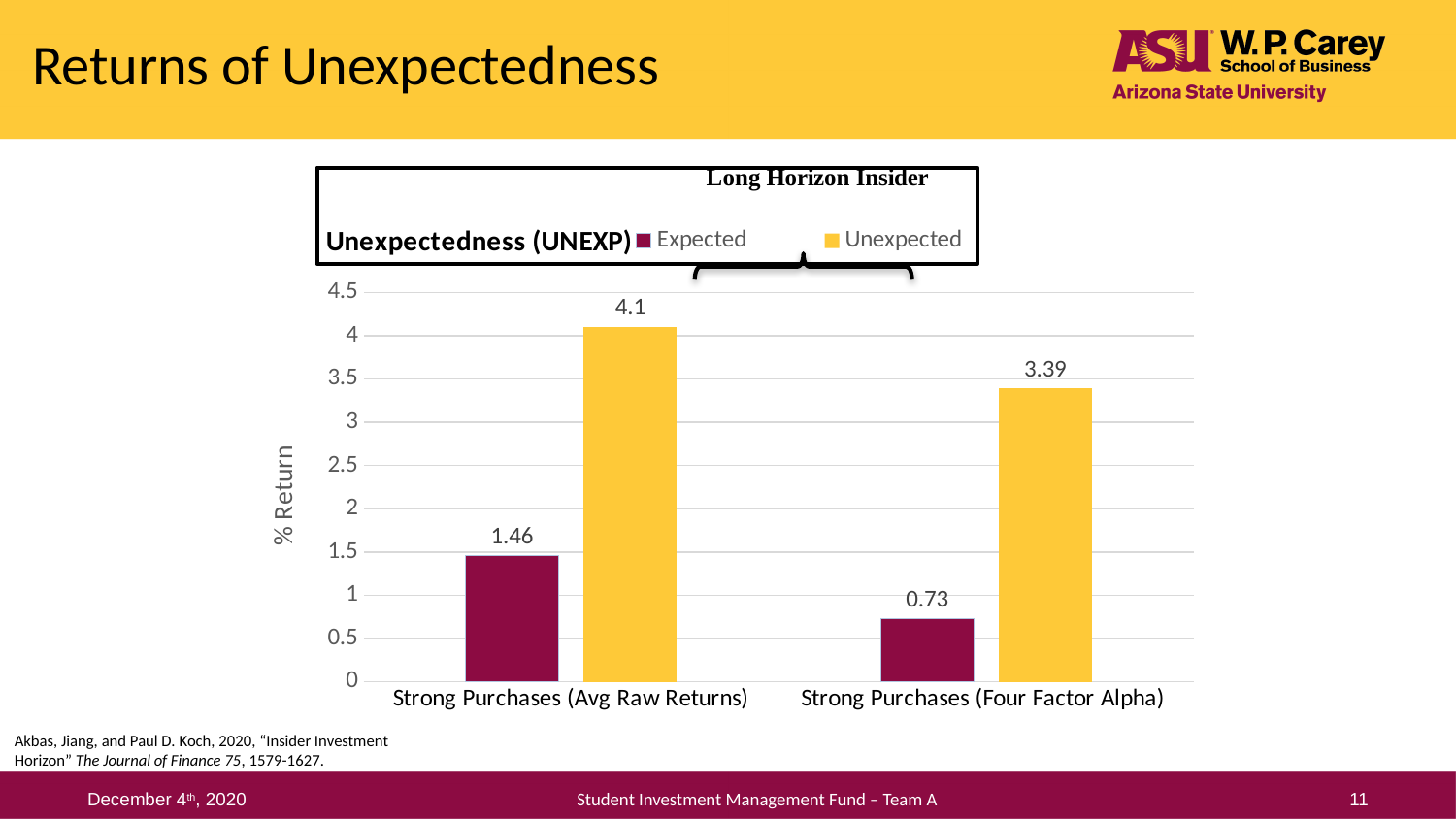
How many series does the legend list? 2 Which is larger: the Expected value for Strong Purchases (Avg Raw Returns) or the Expected value for Strong Purchases (Four Factor Alpha)? Strong Purchases (Avg Raw Returns) What is the Unexpected value for Strong Purchases (Avg Raw Returns)? 4.1 What kind of chart is shown on the slide? Bar chart Which bar has the lowest value on the chart? Expected, Strong Purchases (Four Factor Alpha) What is the Expected value for Strong Purchases (Avg Raw Returns)? 1.46 What is the label on the vertical axis of the chart? % Return What is the Unexpected value for Strong Purchases (Four Factor Alpha)? 3.39 Which bar has the highest value on the chart? Unexpected, Strong Purchases (Avg Raw Returns) What is the difference between the Unexpected and Expected values for Strong Purchases (Four Factor Alpha)? 2.66 What is the Expected value for Strong Purchases (Four Factor Alpha)? 0.73 What is the difference between the Unexpected and Expected values for Strong Purchases (Avg Raw Returns)? 2.64